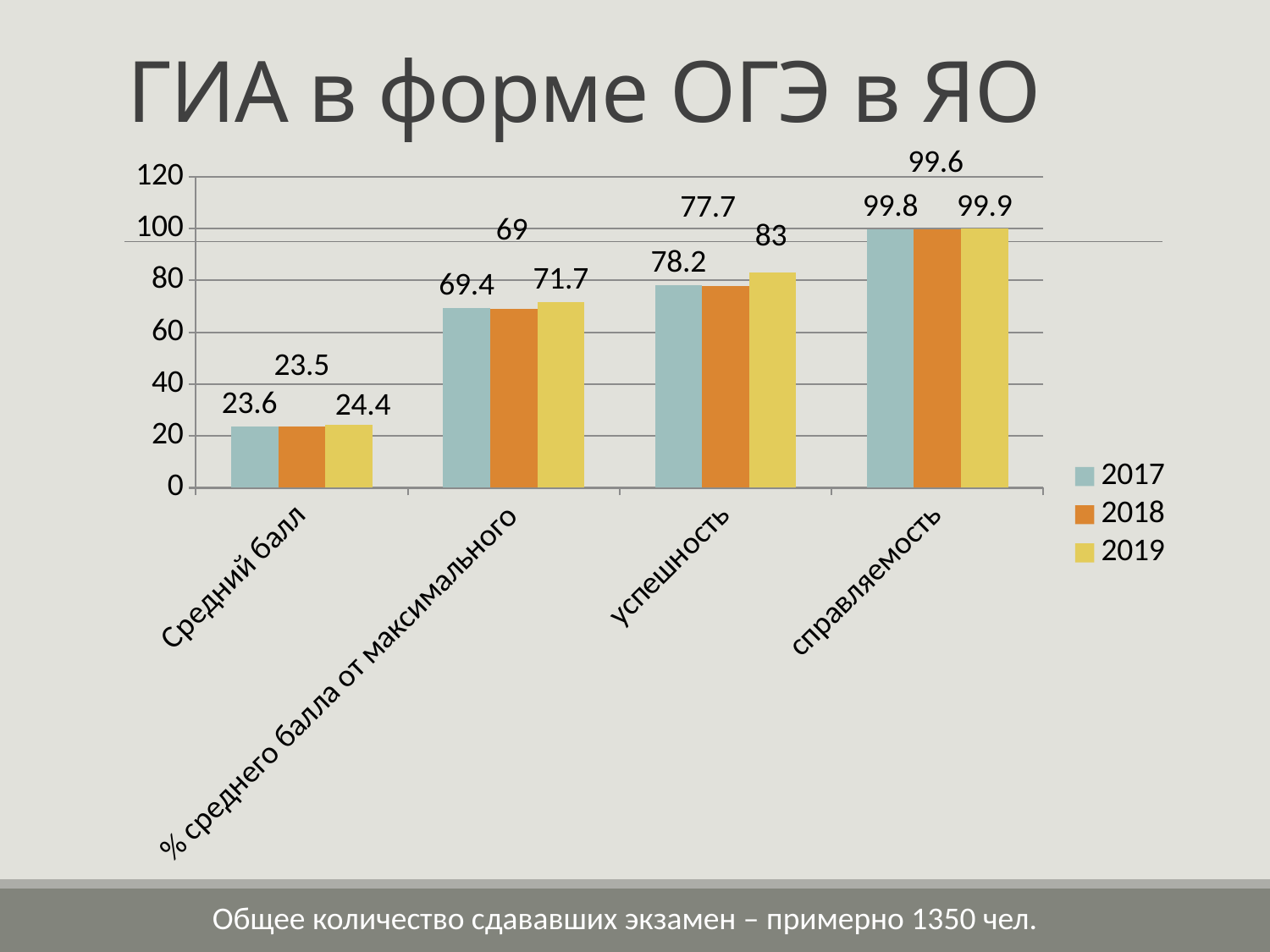
What is the title of the slide? ГИА в форме ОГЭ в ЯО What is the value for 2019 in the "справляемость" category? 99.9 Which category has the lowest values across all years? Средний балл What kind of chart is shown on the slide? bar chart What is the value for 2018 in the "% среднего балла от максимального" category? 69 How many series does the legend list? 3 What is the value for 2019 in the "успешность" category? 83 What is the difference between the 2019 and 2018 values for "успешность"? 5.3 Which is larger in the "% среднего балла от максимального" category: the 2019 value or the 2017 value? 2019 Which category has the highest values across all years? справляемость What is the value for 2017 in the "Средний балл" category? 23.6 How many categories are shown on the x axis? 4